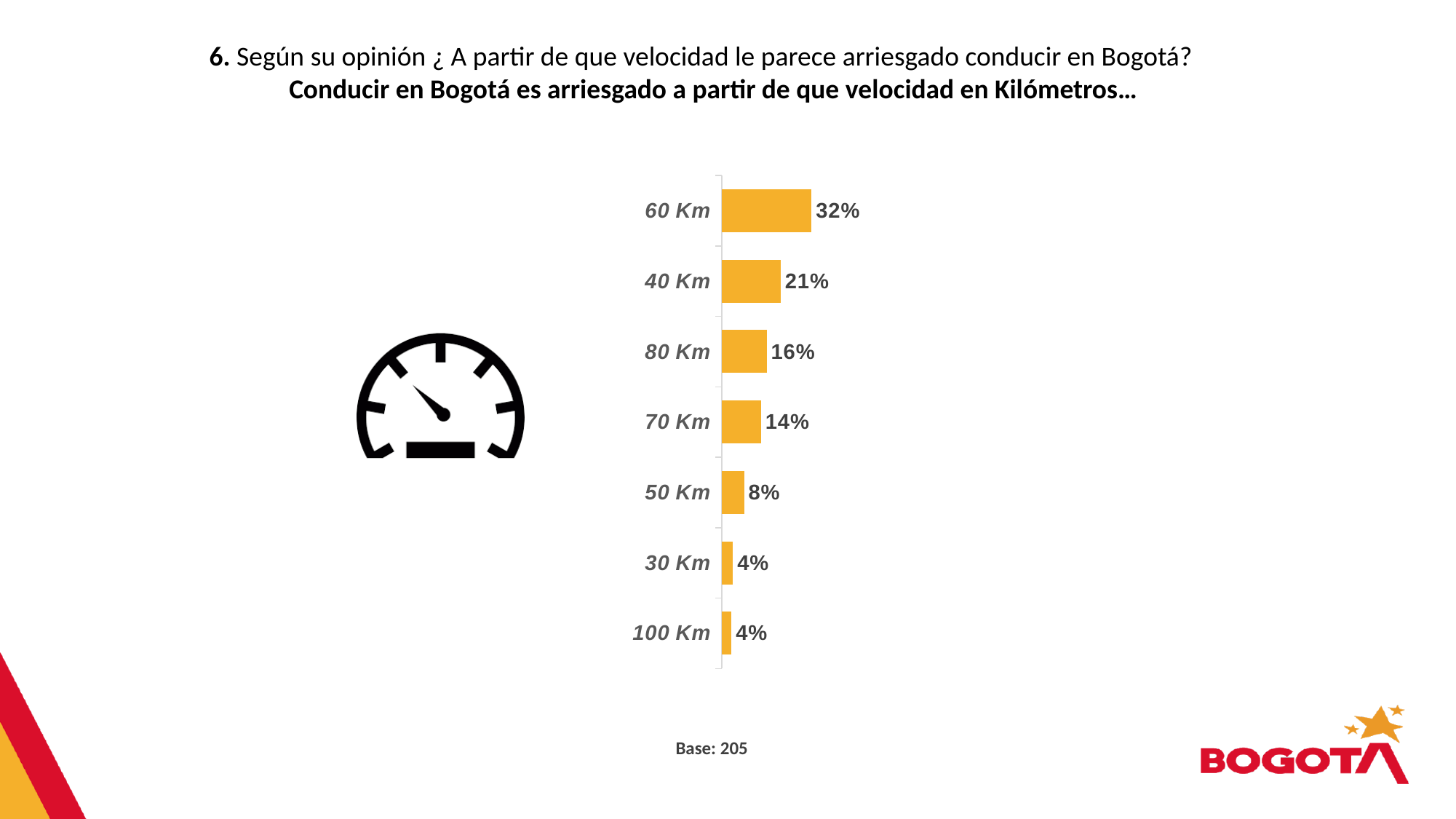
What is the value shown for 40 Km? 21% What kind of chart is shown on the slide? Bar chart What is the base (number of respondents) shown below the chart? 205 How many speed categories are shown in the chart? 7 Which speed category has the highest percentage? 60 Km What is the value shown for 80 Km? 16% Which is larger, the value for 70 Km or the value for 50 Km? 70 Km What is the value shown for 50 Km? 8% What is the difference between the values for 60 Km and 40 Km? 11% What colour are the bars in the chart? Orange/yellow What percentage of respondents said driving in Bogotá is risky from 60 Km? 32% What is the difference between the values for 80 Km and 70 Km? 2%